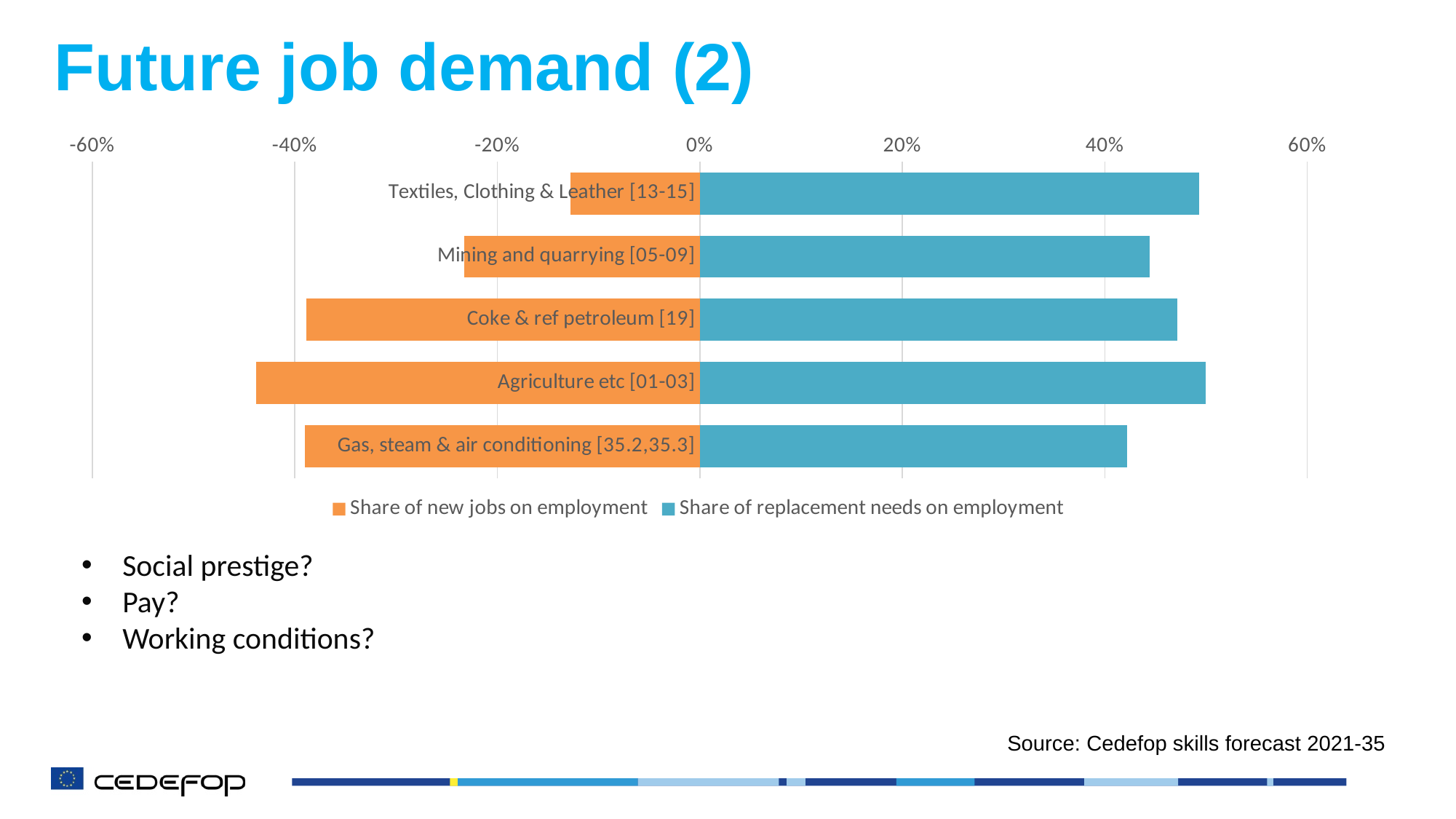
Which category has the least negative (highest) value for Share of new jobs on employment? Textiles, Clothing & Leather [13-15] How many series does the chart legend list? 2 How many industry categories are plotted in the chart? 5 Is the Share of replacement needs on employment for Gas, steam & air conditioning [35.2,35.3] greater or less than 40%? greater Which category has the most negative value for Share of new jobs on employment? Agriculture etc [01-03] Is the Share of new jobs on employment for Mining and quarrying [05-09] greater or less than -20%? less What kind of chart is shown on the slide? bar chart What source is cited for the chart data? Cedefop skills forecast 2021-35 Is the Share of new jobs on employment for Textiles, Clothing & Leather [13-15] greater or less than -20%? greater Which has a larger Share of replacement needs on employment: Textiles, Clothing & Leather [13-15] or Gas, steam & air conditioning [35.2,35.3]? Textiles, Clothing & Leather [13-15] Which colour represents Share of new jobs on employment in the chart? orange